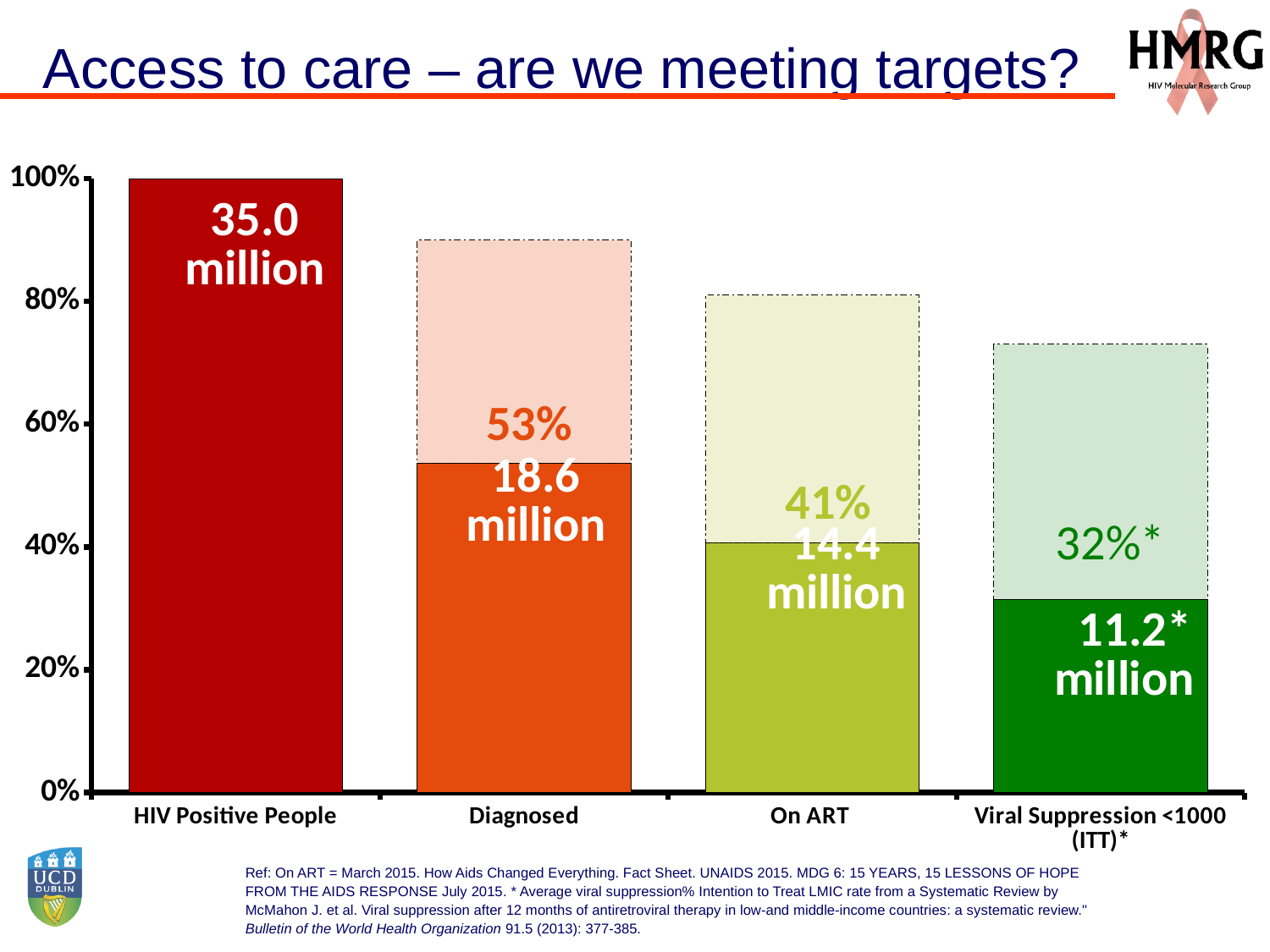
Which category has the highest solid bar? HIV Positive People How many categories are shown on the x axis? 4 How many million people are shown as being On ART? 14.4 million What percentage is shown for the Diagnosed bar? 53% What percentage is labelled on the Viral Suppression <1000 (ITT)* bar? 32%* What is the difference in percentage points between the Diagnosed bar (53%) and the On ART bar (41%)? 12 What type of chart is shown on the slide? Bar chart How many million people are labelled on the Diagnosed bar? 18.6 million Which category has the lowest solid bar? Viral Suppression <1000 (ITT)* What number of people is labelled on the HIV Positive People bar? 35.0 million Which is larger, the number of people On ART or the number with Viral Suppression? On ART Is the solid bar for On ART greater or less than 60%? less